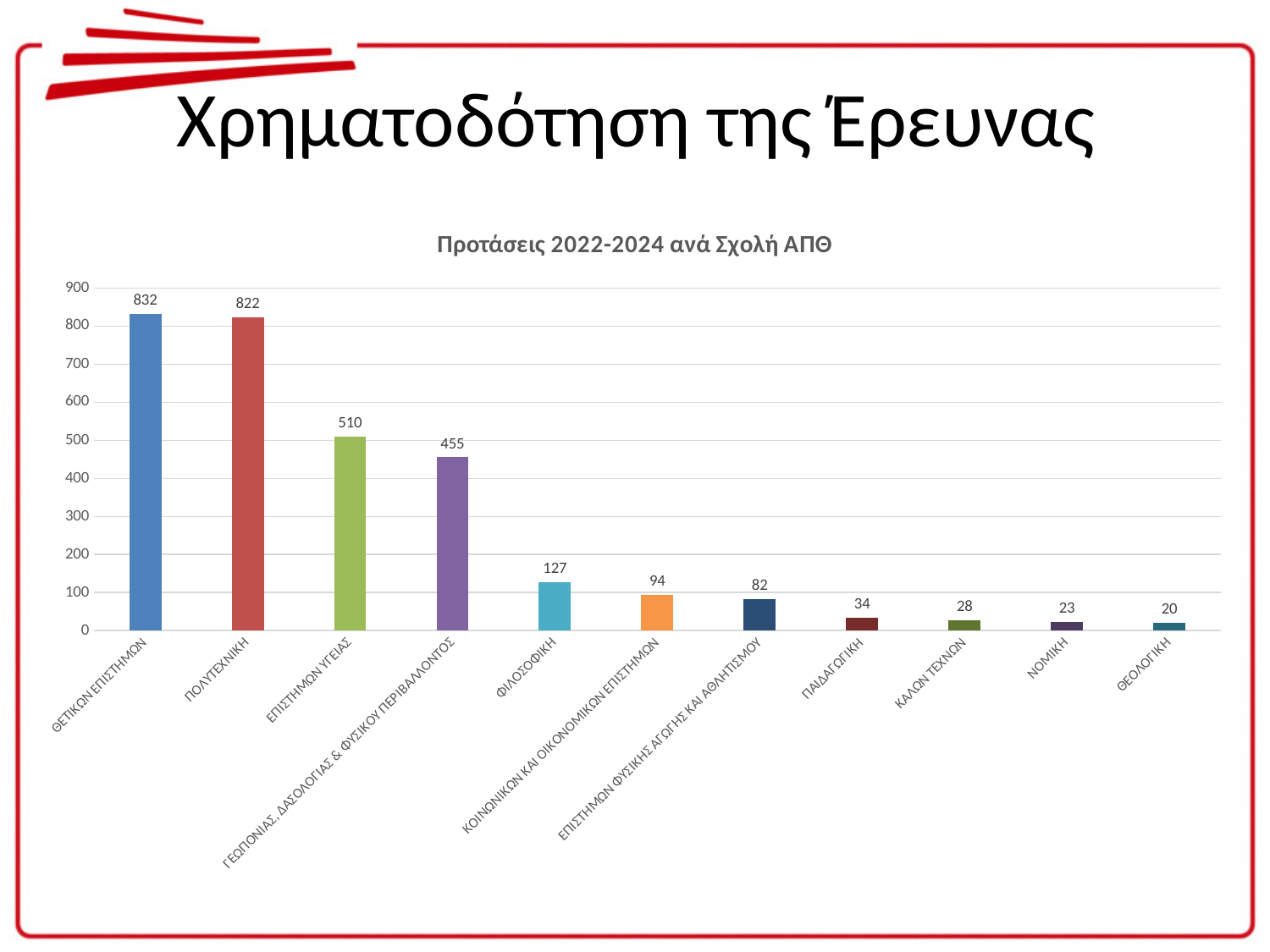
What is the value for ΝΟΜΙΚΗ? 23 Which is larger, the value for ΚΟΙΝΩΝΙΚΩΝ ΚΑΙ ΟΙΚΟΝΟΜΙΚΩΝ ΕΠΙΣΤΗΜΩΝ or the value for ΕΠΙΣΤΗΜΗΣ ΦΥΣΙΚΗΣ ΑΓΩΓΗΣ ΚΑΙ ΑΘΛΗΤΙΣΜΟΥ? ΚΟΙΝΩΝΙΚΩΝ ΚΑΙ ΟΙΚΟΝΟΜΙΚΩΝ ΕΠΙΣΤΗΜΩΝ What kind of chart is shown on the slide? bar chart Is the value for ΠΑΙΔΑΓΩΓΙΚΗ greater or less than 100? less Which school has the highest value? ΘΕΤΙΚΩΝ ΕΠΙΣΤΗΜΩΝ What is the value for ΦΙΛΟΣΟΦΙΚΗ? 127 What is the title of the chart? Προτάσεις 2022-2024 ανά Σχολή ΑΠΘ Do the values rise or fall from left to right along the x axis? fall What is the value for ΠΟΛΥΤΕΧΝΙΚΗ? 822 How many schools are shown on the chart? 11 Which school has the lowest value? ΘΕΟΛΟΓΙΚΗ What is the difference between the values for ΕΠΙΣΤΗΜΩΝ ΥΓΕΙΑΣ and ΓΕΩΠΟΝΙΑΣ, ΔΑΣΟΛΟΓΙΑΣ & ΦΥΣΙΚΟΥ ΠΕΡΙΒΑΛΛΟΝΤΟΣ? 55